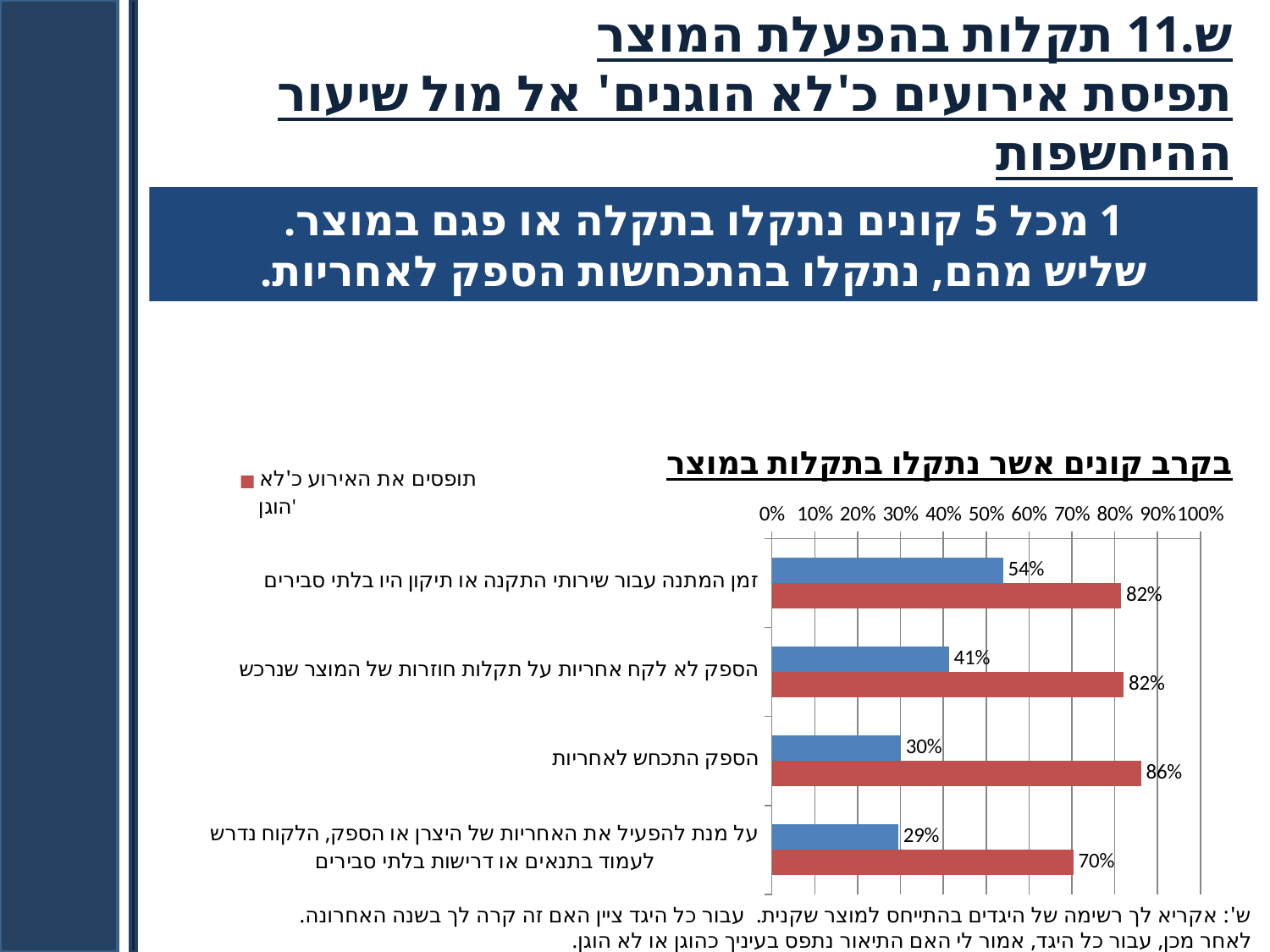
What is the value of the red bar for the category 'על מנת להפעיל את האחריות של היצרן או הספק, הלקוח נדרש לעמוד בתנאים או דרישות בלתי סבירים'? 70% What is the value of the blue bar for the category 'הספק לא לקח אחריות על תקלות חוזרות של המוצר שנרכש'? 41% What is the value of the blue bar for the category 'זמן המתנה עבור שירותי התקנה או תיקון היו בלתי סבירים'? 54% Which category has the highest value in the red series (תופסים את האירוע כ'לא הוגן')? הספק התכחש לאחריות What type of chart is shown on the slide? bar chart What colour is the series labelled 'תופסים את האירוע כ'לא הוגן'' in the legend? red For the category 'זמן המתנה עבור שירותי התקנה או תיקון היו בלתי סבירים', which bar is larger, the blue or the red? red What is the title of the chart? בקרב קונים אשר נתקלו בתקלות במוצר How many categories are plotted in the chart? 4 What is the value of the red series (תופסים את האירוע כ'לא הוגן') for the category 'הספק התכחש לאחריות'? 86% What is the difference between the red and blue bars for the category 'הספק התכחש לאחריות'? 56% Which category has the lowest value in the blue series? על מנת להפעיל את האחריות של היצרן או הספק, הלקוח נדרש לעמוד בתנאים או דרישות בלתי סבירים